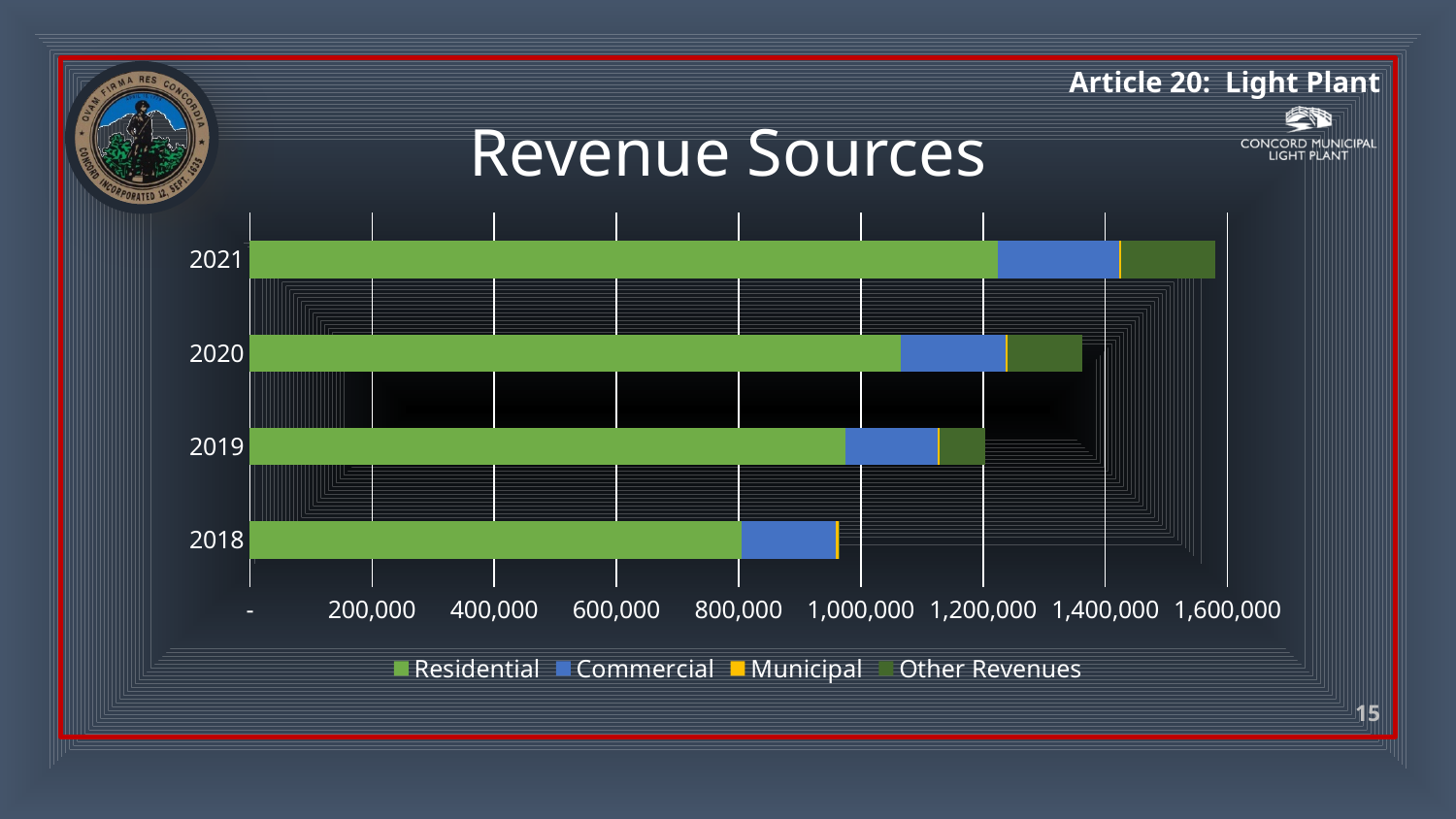
How many series does the legend list? 4 Which year has the larger total bar, 2019 or 2020? 2020 What is the title of the chart? Revenue Sources Is the total bar for 2021 greater or less than 1,400,000? greater How many years are shown on the chart? 4 Which year has the shortest total bar? 2018 Which series is shown in yellow in the legend? Municipal Is the total bar for 2018 greater or less than 1,000,000? less What kind of chart is shown on the slide? Stacked bar chart Is the total bar for 2020 greater or less than 1,200,000? greater Do the total revenues rise or fall from 2018 to 2021? rise Which year has the longest total bar? 2021